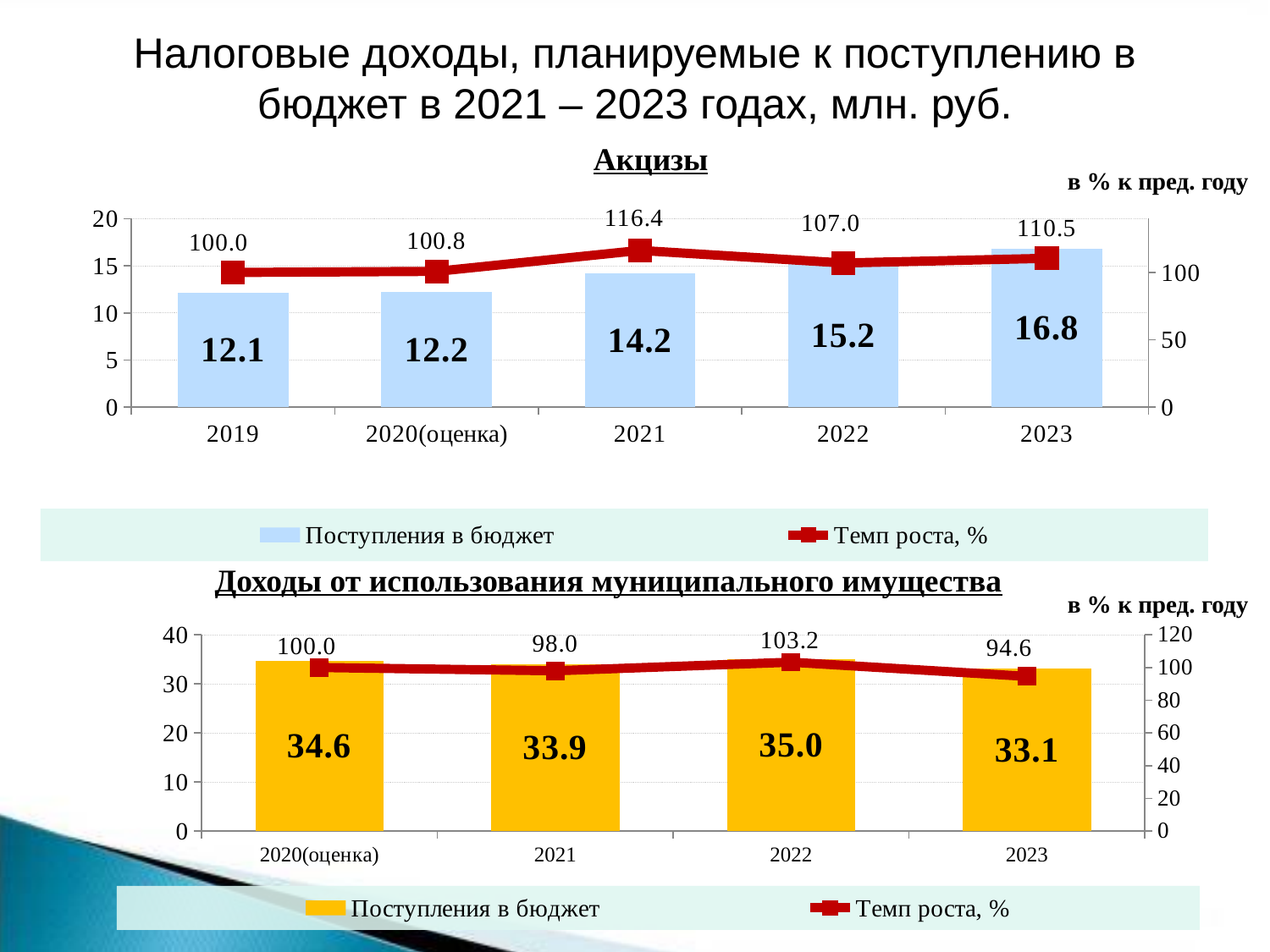
In the "Доходы от использования муниципального имущества" chart, how many series does the legend list? 2 In the "Доходы от использования муниципального имущества" chart, what is the value of "Поступления в бюджет" for 2022? 35.0 In the "Доходы от использования муниципального имущества" chart, which year has the lowest "Поступления в бюджет" value? 2023 In the "Доходы от использования муниципального имущества" chart, which is larger: the "Темп роста, %" value for 2021 or for 2022? 2022 In the "Доходы от использования муниципального имущества" chart, what is the "Темп роста, %" value for 2023? 94.6 What type of chart is the "Акцизы" chart? Combined bar and line chart In the "Акцизы" chart, what is the value of "Поступления в бюджет" for 2021? 14.2 In the "Акцизы" chart, what is the difference between the "Поступления в бюджет" values for 2023 and 2019? 4.7 In the "Акцизы" chart, do the "Поступления в бюджет" values rise or fall from 2019 to 2023? rise In the "Акцизы" chart, which year has the highest "Поступления в бюджет" value? 2023 In the "Акцизы" chart, how many years are shown on the x axis? 5 In the "Акцизы" chart, what is the "Темп роста, %" value for 2021? 116.4